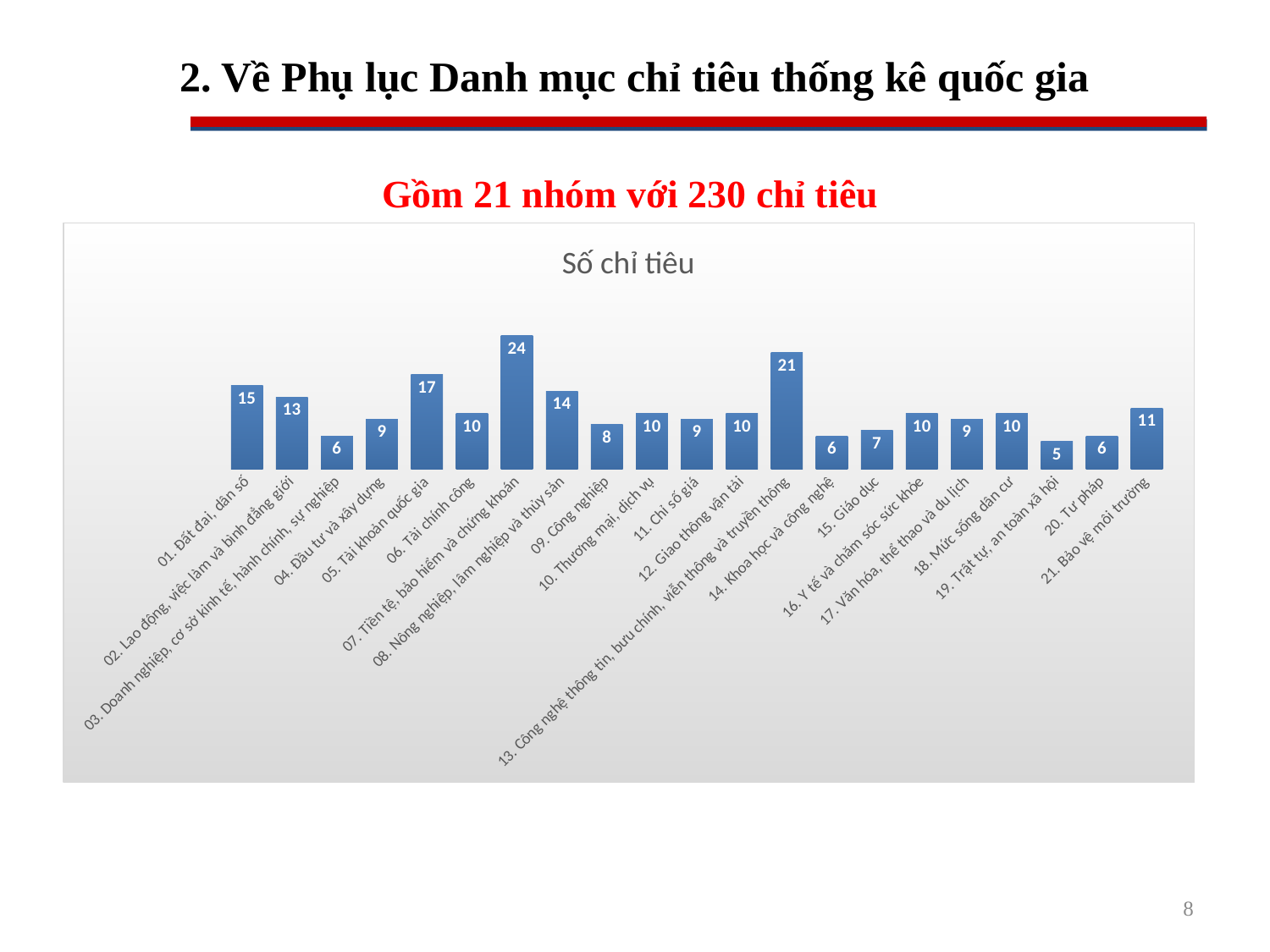
What is the value for "01. Đất đai, dân số"? 15 What kind of chart is shown on the slide? Bar chart What is the value for "15. Giáo dục"? 7 What is the value for "07. Tiền tệ, bảo hiểm và chứng khoán"? 24 What is the value for "21. Bảo vệ môi trường"? 11 How many categories are shown in the chart? 21 Which category has the lowest value? 19. Trật tự, an toàn xã hội What is the title of the chart? Số chỉ tiêu Which category has the highest value? 07. Tiền tệ, bảo hiểm và chứng khoán What is the difference between the values for "02. Lao động, việc làm và bình đẳng giới" and "20. Tư pháp"? 7 Which is larger, the value for "05. Tài khoản quốc gia" or the value for "08. Nông nghiệp, lâm nghiệp và thủy sản"? 05. Tài khoản quốc gia What is the difference between the values for "07. Tiền tệ, bảo hiểm và chứng khoán" and "13. Công nghệ thông tin, bưu chính, viễn thông và truyền thông"? 3